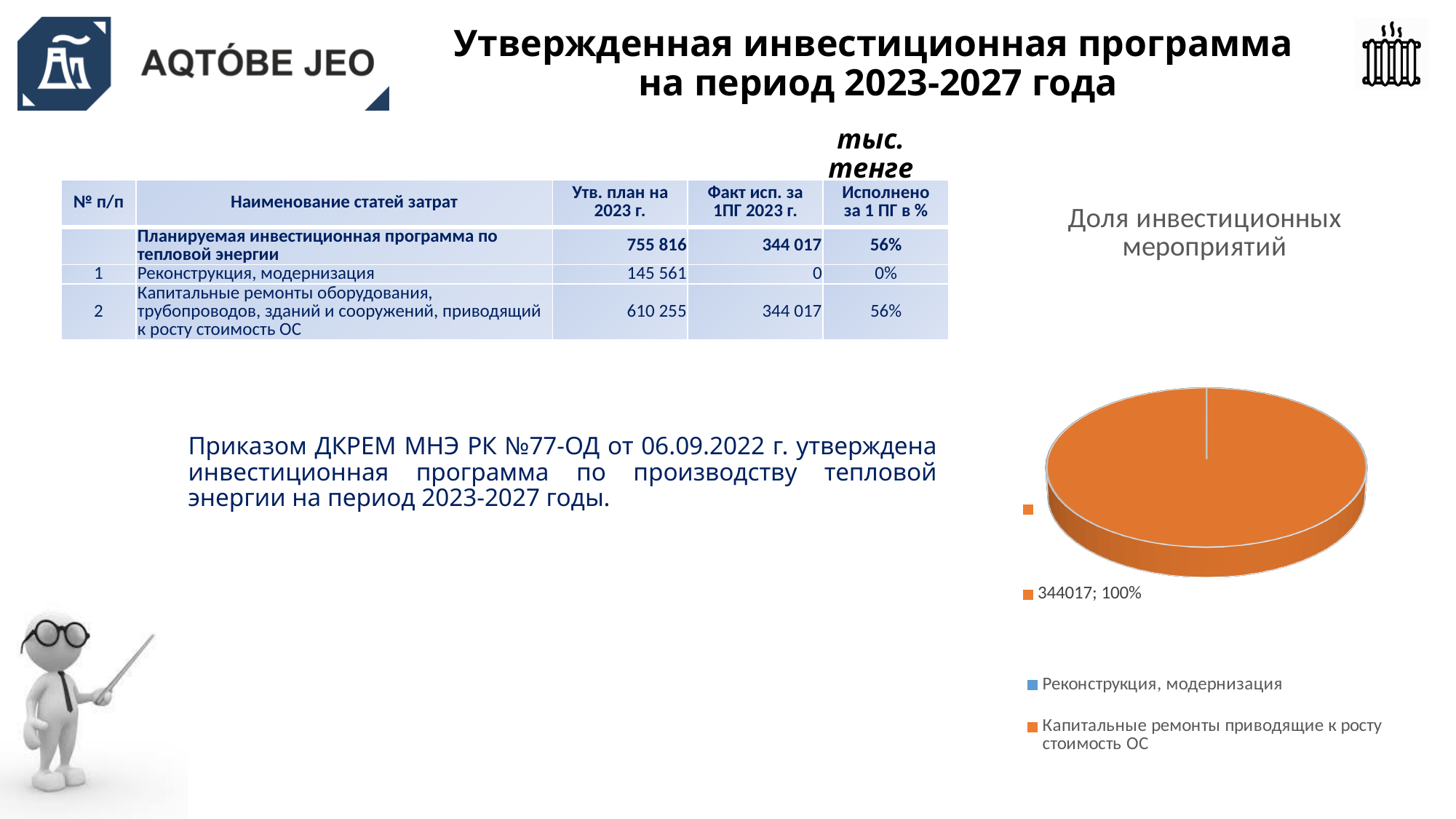
Which category has the smallest share of the pie? Реконструкция, модернизация What is the title of the chart on the slide? Доля инвестиционных мероприятий How many slices are visibly drawn in the pie chart? 1 What share of the pie does the slice for "Капитальные ремонты приводящие к росту стоимость ОС" represent? 100% What colour is the slice for "Капитальные ремонты приводящие к росту стоимость ОС" in the pie chart? orange Which is larger in the pie chart: the share for "Реконструкция, модернизация" or the share for "Капитальные ремонты приводящие к росту стоимость ОС"? Капитальные ремонты приводящие к росту стоимость ОС What value is printed on the data label of the pie slice for "Капитальные ремонты приводящие к росту стоимость ОС"? 344017 Which category accounts for the largest share of the pie? Капитальные ремонты приводящие к росту стоимость ОС What kind of chart is shown on the slide? pie chart How many entries does the chart's legend list? 2